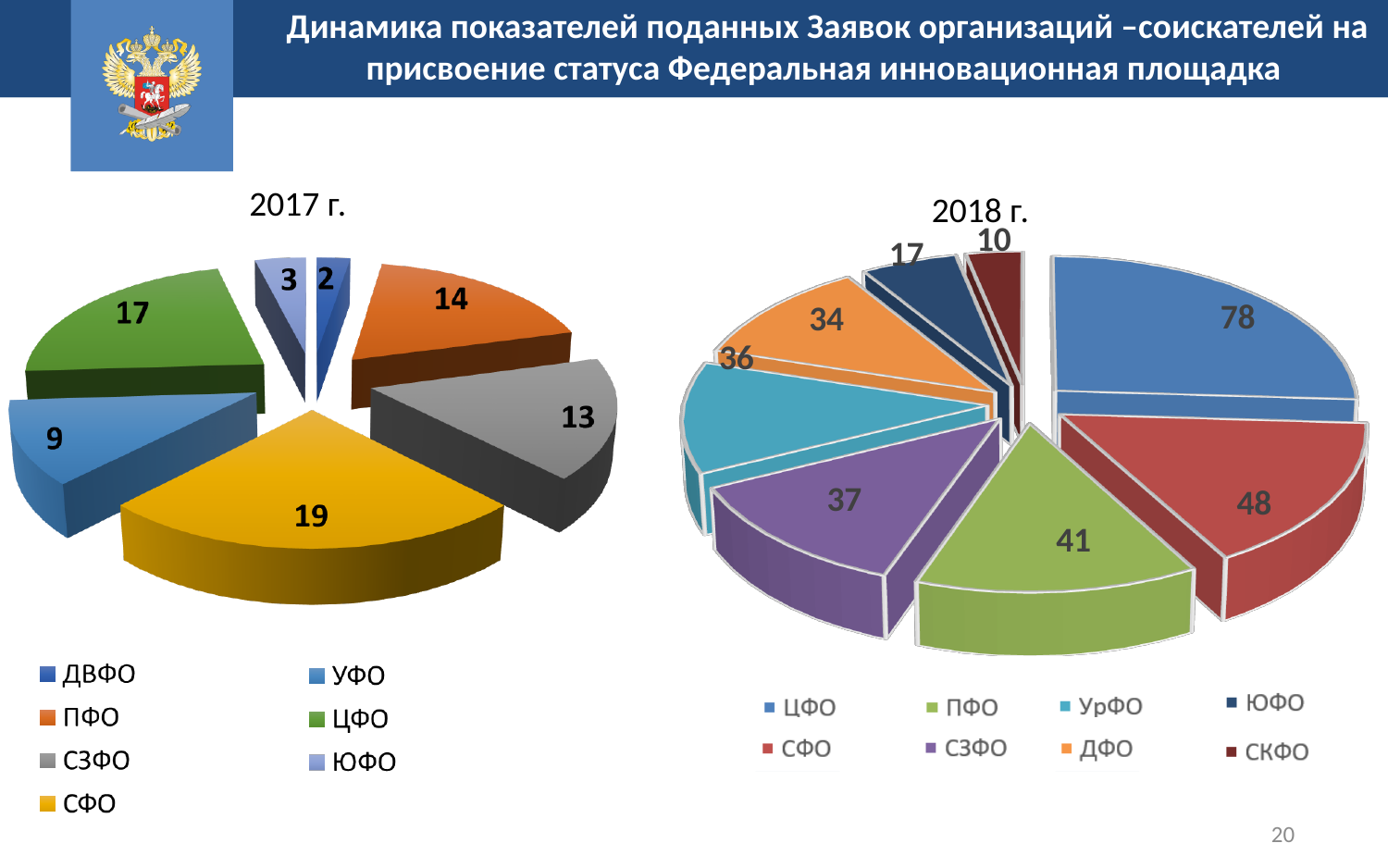
In the 2018 pie chart, what is the value for СЗФО? 37 In the 2017 pie chart, what is the value for ЦФО? 17 In the 2017 pie chart, what is the value for СФО? 19 In the 2018 pie chart, what is the difference between the values for ЦФО and СФО? 30 In the 2018 pie chart, what is the value for ЦФО? 78 How many entries does the legend of the 2017 pie chart list? 7 What type of chart is used for the 2017 data? Pie chart In the 2018 pie chart, which region has the largest slice? ЦФО In the 2017 pie chart, which region has the smallest slice? ДВФО In the 2017 pie chart, which is larger, the value for ПФО or the value for СЗФО? ПФО In the 2018 pie chart, which region has the smallest slice? СКФО How many slices does the 2018 pie chart have? 8